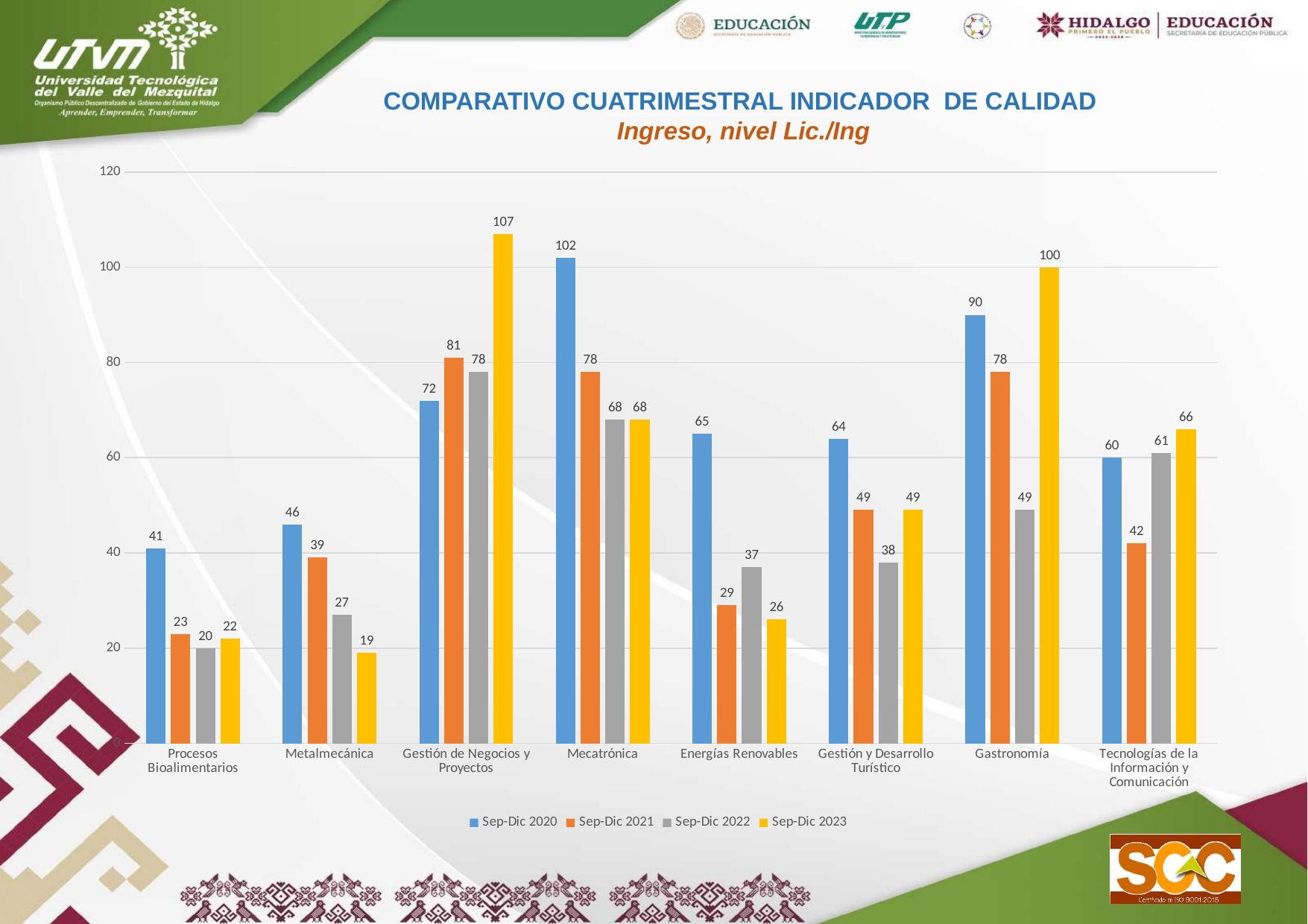
Which category has the lowest Sep-Dic 2023 value? Metalmecánica What is the Sep-Dic 2022 value for Energías Renovables? 37 What is the Sep-Dic 2020 value for Mecatrónica? 102 What is the Sep-Dic 2023 value for Gestión de Negocios y Proyectos? 107 What is the difference between the Sep-Dic 2023 and Sep-Dic 2020 values for Gastronomía? 10 What is the subtitle shown below the chart title? Ingreso, nivel Lic./Ing What is the Sep-Dic 2021 value for Tecnologías de la Información y Comunicación? 42 How many categories are shown on the x axis? 8 What kind of chart is shown on the slide? Bar chart Which is larger for Metalmecánica: the Sep-Dic 2020 value or the Sep-Dic 2021 value? Sep-Dic 2020 Which category has the highest Sep-Dic 2020 value? Mecatrónica How many series does the legend list? 4